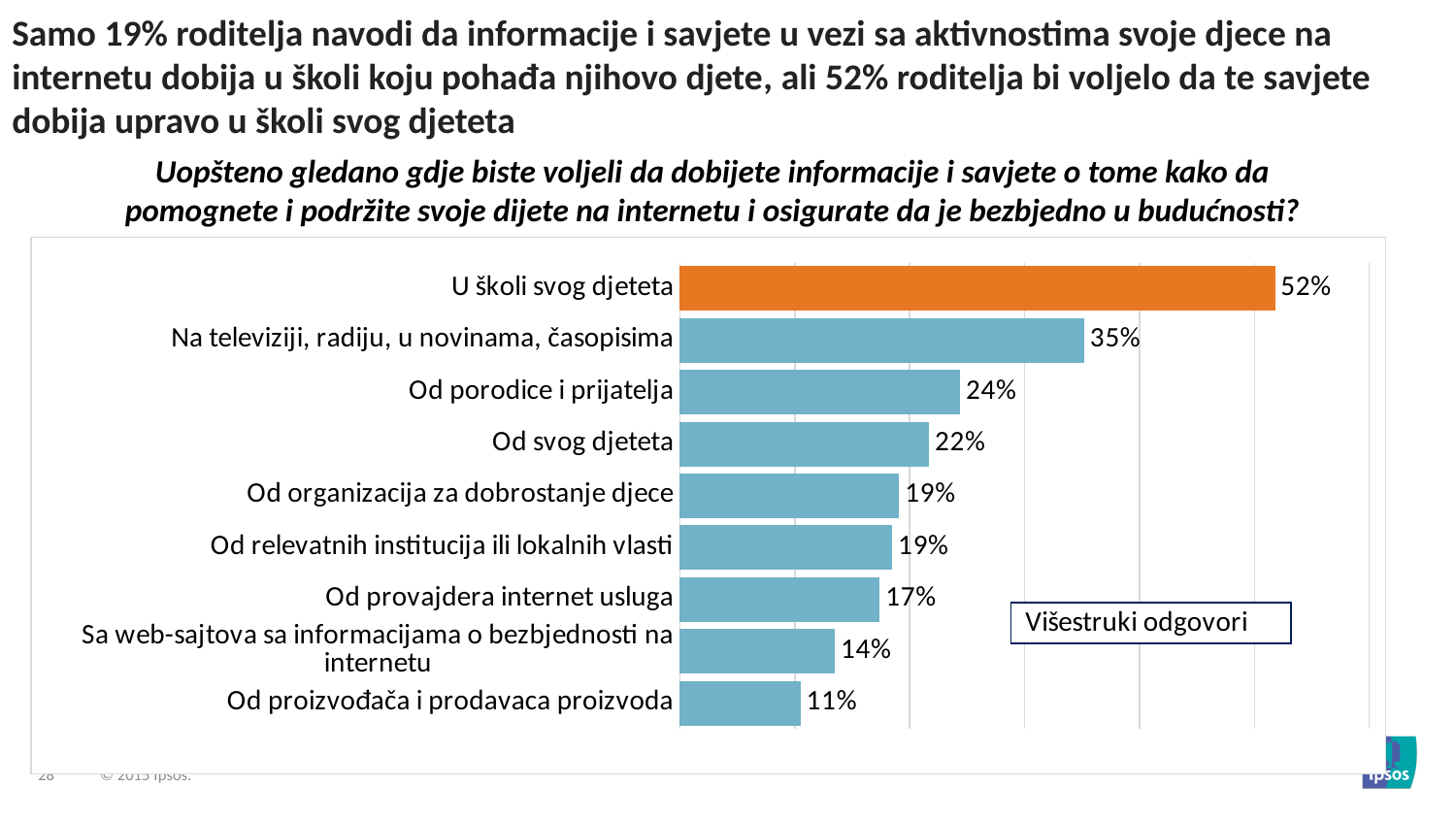
What is the difference between 'U školi svog djeteta' and 'Na televiziji, radiju, u novinama, časopisima'? 17% What is the value for 'Od provajdera internet usluga'? 17% What is the difference between 'Od organizacija za dobrostanje djece' and 'Sa web-sajtova sa informacijama o bezbjednosti na internetu'? 5% What is the value for 'Od proizvođača i prodavaca proizvoda'? 11% Which is larger: 'Od porodice i prijatelja' or 'Od svog djeteta'? Od porodice i prijatelja What is the value for 'U školi svog djeteta'? 52% Which category has the lowest value? Od proizvođača i prodavaca proizvoda Which bar is highlighted in orange? U školi svog djeteta Which category has the highest value? U školi svog djeteta What kind of chart is shown on the slide? Bar chart How many categories are shown in the chart? 9 What is the value for 'Na televiziji, radiju, u novinama, časopisima'? 35%